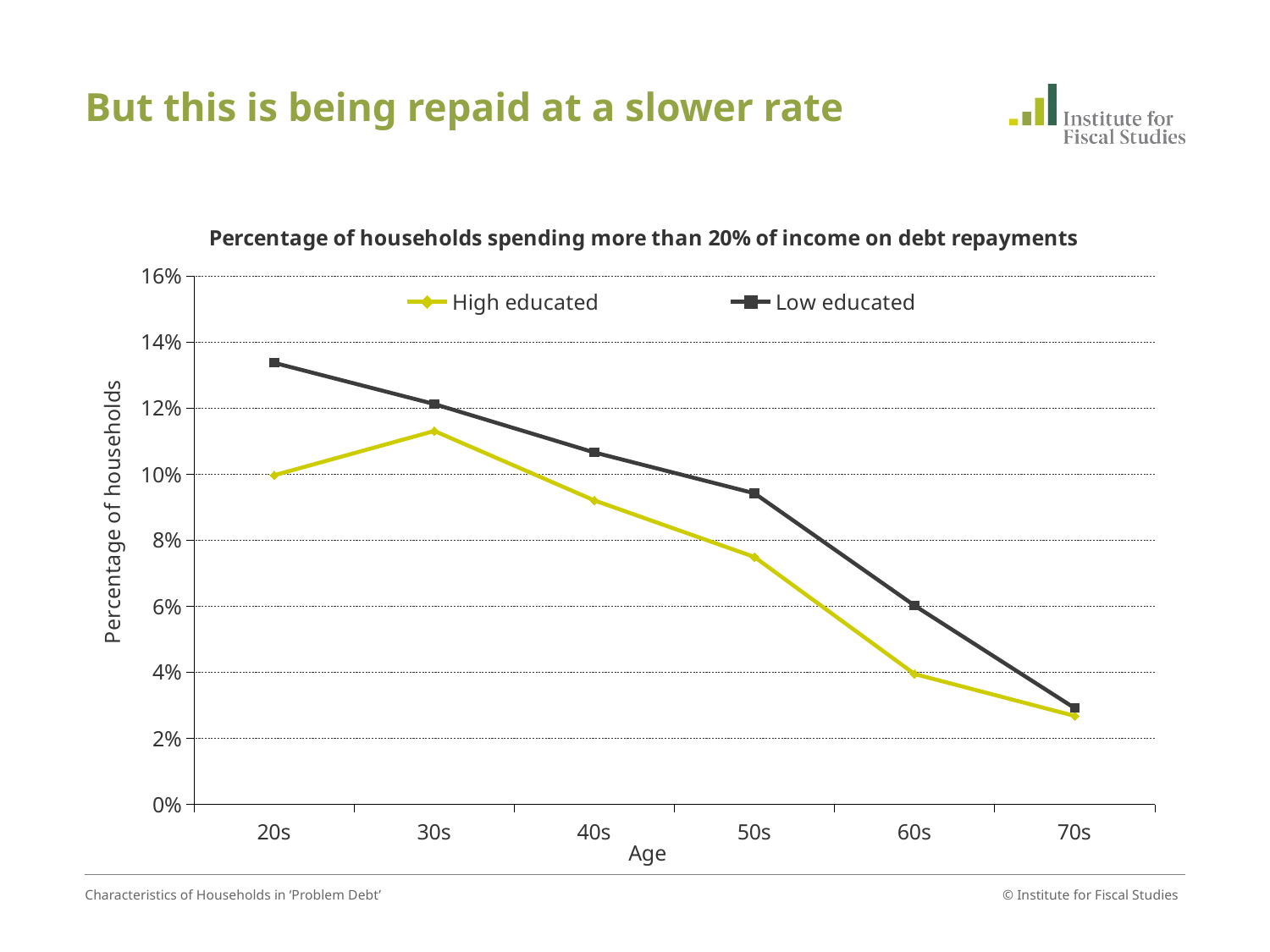
Is the value for High educated at age 60s greater or less than 6%? less What kind of chart is shown on the slide? Line chart How many age groups are plotted along the x axis? 6 Is the value for High educated at age 50s greater or less than 8%? less Does the Low educated line rise or fall as age increases from 20s to 70s? Falls For the High educated series, which age group has the lowest value? 70s Is the value for Low educated at age 20s greater or less than 12%? greater How many series does the legend list? 2 At age 40s, which series has the larger value, High educated or Low educated? Low educated For the Low educated series, which age group has the highest value? 20s For the High educated series, which age group has the highest value? 30s What is the title of the chart? Percentage of households spending more than 20% of income on debt repayments